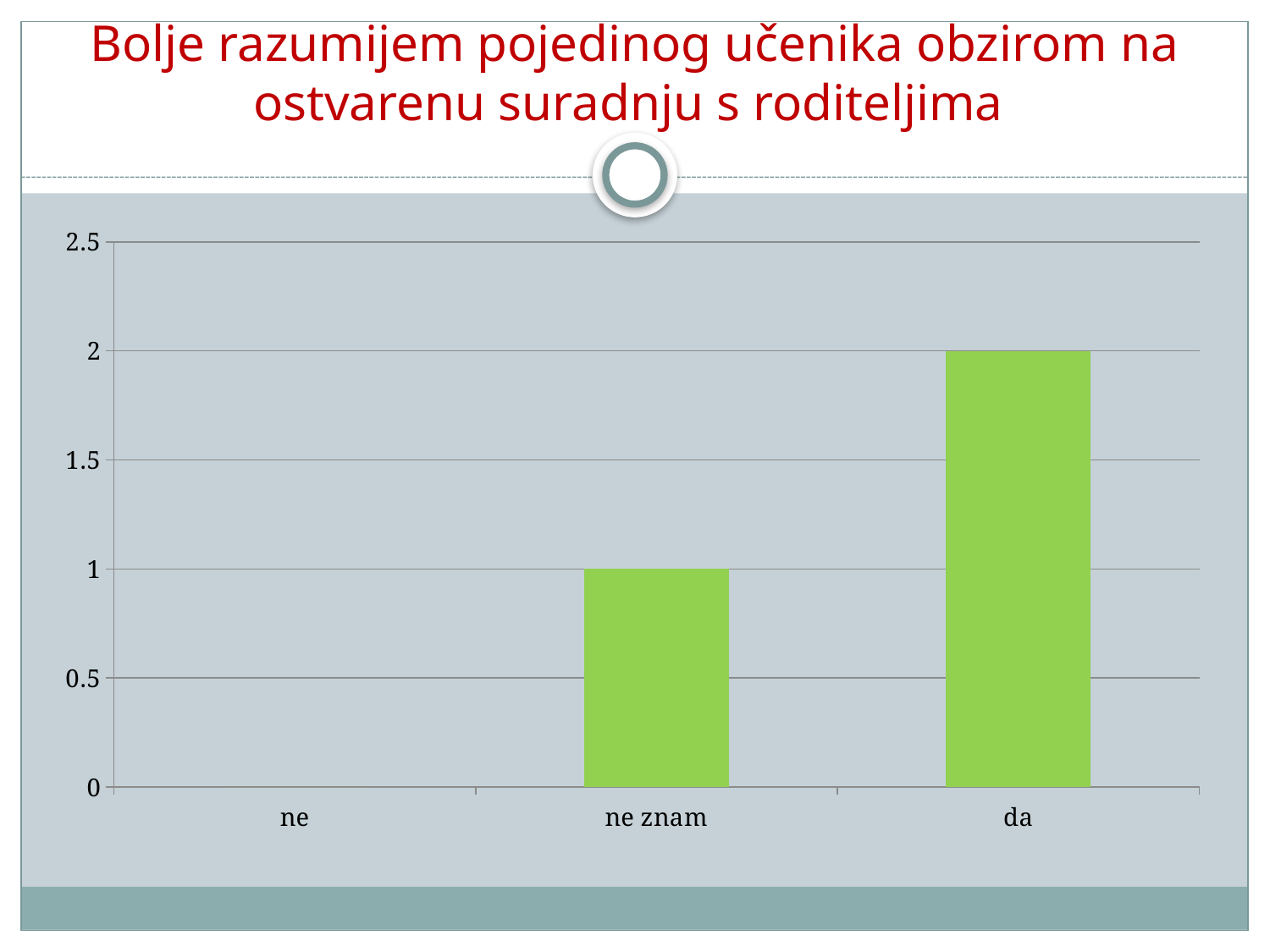
What is the value for "ne znam"? 1 Which category has the lowest value? ne Do the values rise or fall from left to right along the x axis? rise Is the value for "ne znam" greater or less than 1.5? less What is the difference between the values for "da" and "ne znam"? 1 Which is larger, the value for "ne znam" or the value for "da"? da What kind of chart is shown on the slide? bar chart What is the value for "ne"? 0 Is the value for "da" greater or less than 1.5? greater How many categories are shown on the x axis? 3 Which category has the highest value? da What is the value for "da"? 2